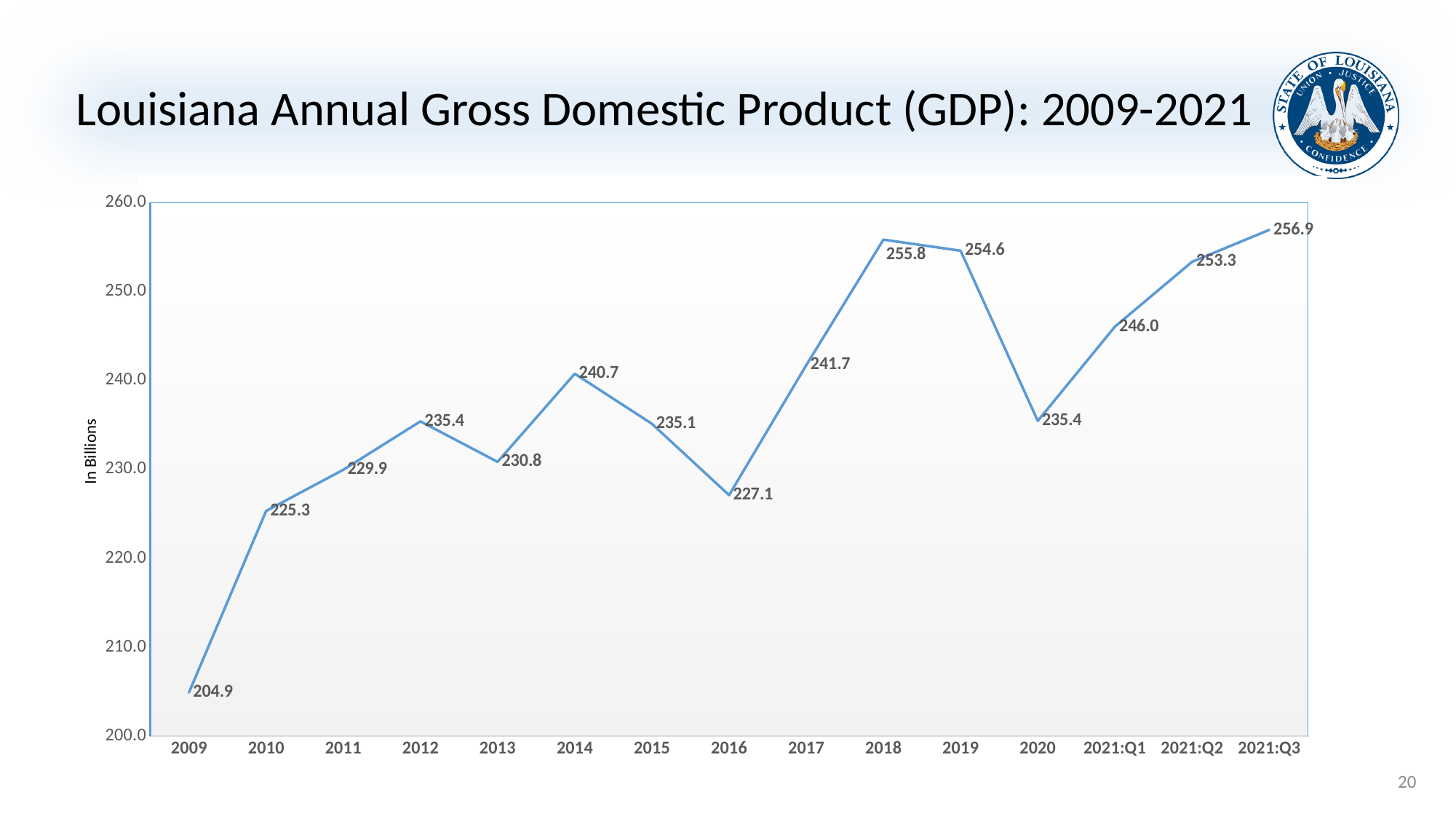
Which period has the highest GDP value? 2021:Q3 What is the label on the vertical axis? In Billions Which period has the lowest GDP value? 2009 How many data points are plotted on the chart? 15 Which is larger, the GDP value for 2014 or for 2017? 2017 What kind of chart is shown on the slide? Line chart What is the GDP value for 2016? 227.1 What is the GDP value for 2009? 204.9 What is the difference between the GDP values for 2019 and 2020? 19.2 What is the GDP value for 2018? 255.8 What is the difference between the GDP values for 2018 and 2019? 1.2 What is the GDP value for 2021:Q3? 256.9